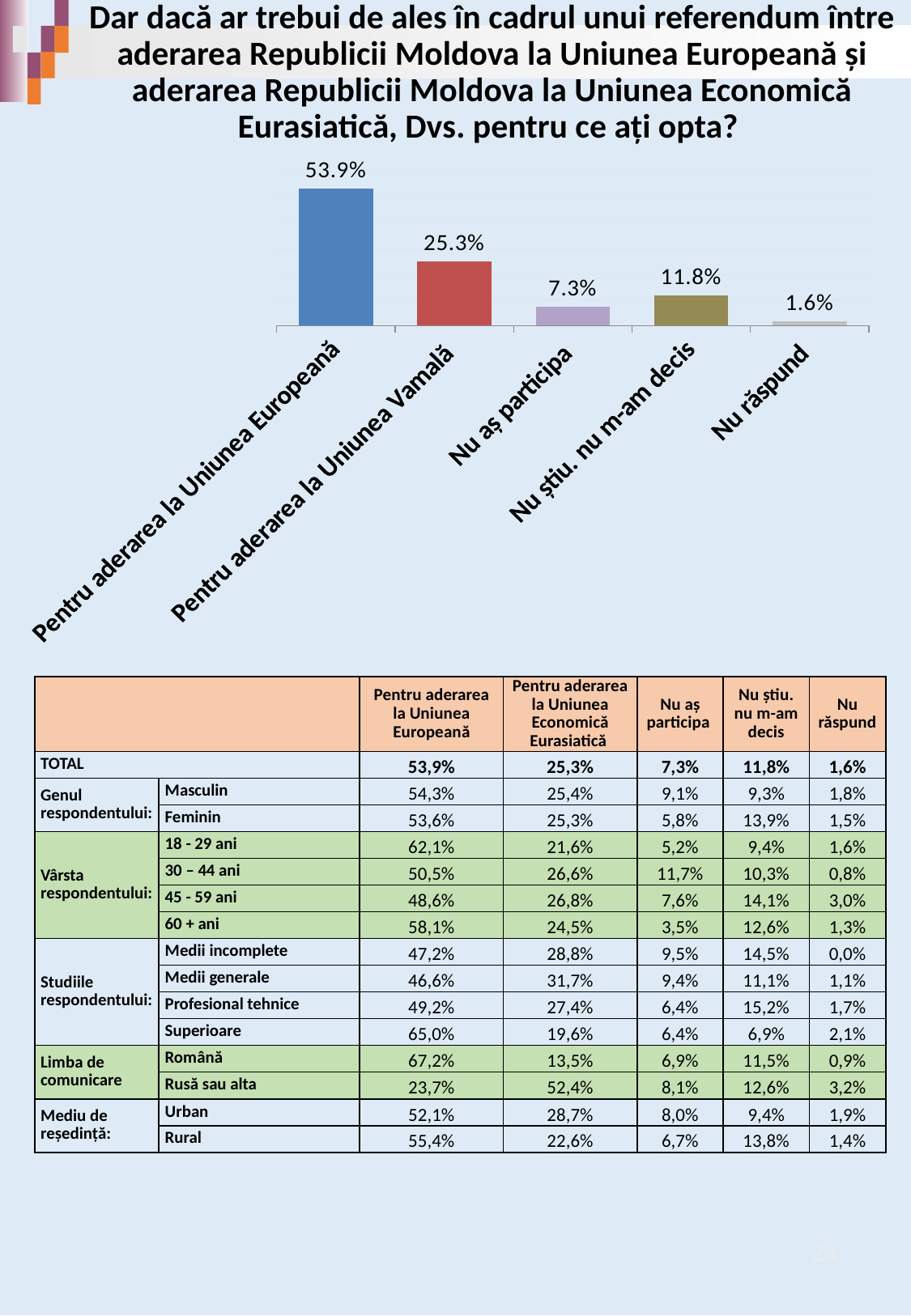
What is the value for "Pentru aderarea la Uniunea Europeană" in the bar chart? 53.9% What is the value for "Nu aș participa" in the bar chart? 7.3% What is the difference between the values for "Nu știu. nu m-am decis" and "Nu aș participa"? 4.5% What is the value for "Nu știu. nu m-am decis" in the bar chart? 11.8% Which category has the lowest value in the bar chart? Nu răspund Which category has the highest value in the bar chart? Pentru aderarea la Uniunea Europeană What is the difference between the values for "Pentru aderarea la Uniunea Europeană" and "Pentru aderarea la Uniunea Vamală"? 28.6% What is the value for "Nu răspund" in the bar chart? 1.6% How many categories are shown in the bar chart? 5 What is the value for "Pentru aderarea la Uniunea Vamală" in the bar chart? 25.3% Which is larger in the bar chart: "Nu aș participa" or "Nu știu. nu m-am decis"? Nu știu. nu m-am decis What type of chart is shown on the slide? Bar chart